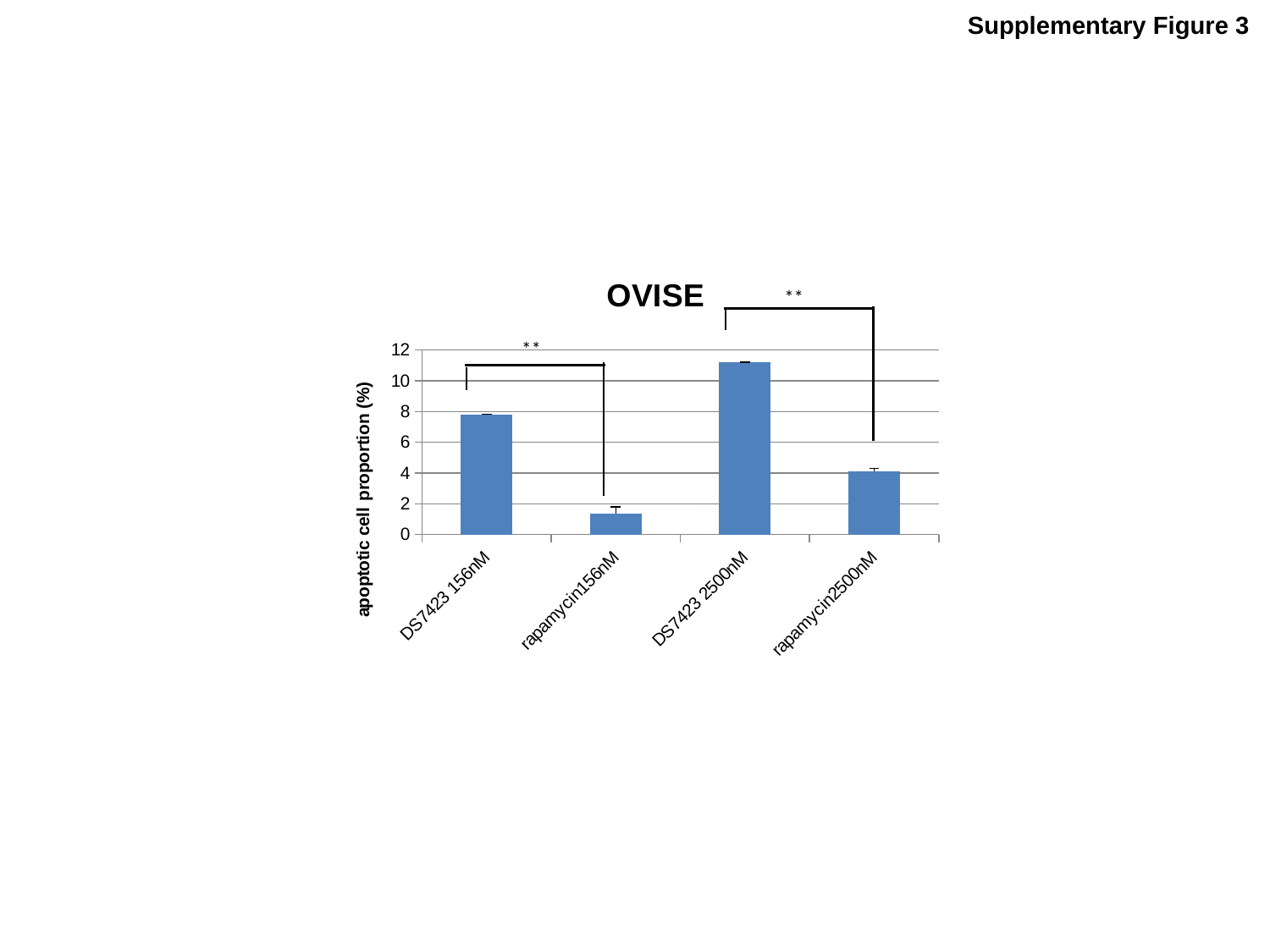
What is the label of the y axis? apoptotic cell proportion (%) Is the value for rapamycin2500nM greater or less than 6? less Is the value for rapamycin156nM greater or less than 2? less Which is larger, the value for DS7423 156nM or the value for rapamycin156nM? DS7423 156nM What is the title of the chart? OVISE Which is larger, the value for DS7423 2500nM or the value for rapamycin2500nM? DS7423 2500nM Which category has the highest apoptotic cell proportion? DS7423 2500nM What kind of chart is shown on the slide? bar chart Which category has the lowest apoptotic cell proportion? rapamycin156nM How many categories are plotted on the x axis of the chart? 4 Is the value for DS7423 156nM greater or less than 6? greater